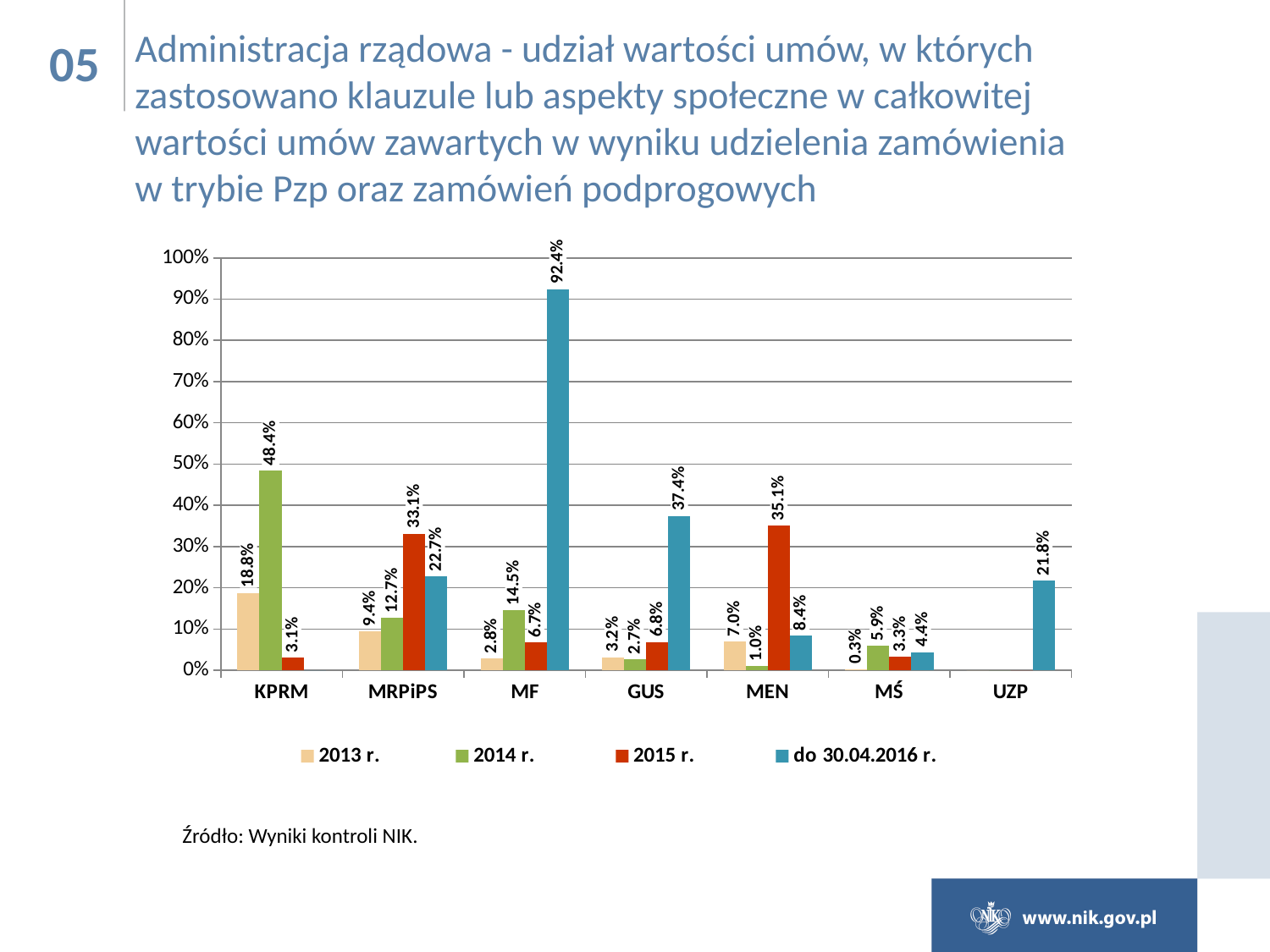
What is the value for MEN in the 2015 r. series? 35.1% Is the 'do 30.04.2016 r.' value for GUS greater or less than 30%? greater What is the difference between the 2015 r. value for MRPiPS and the 2015 r. value for KPRM? 30.0% What is the value for KPRM in the 2014 r. series? 48.4% Which category has the highest value in the 'do 30.04.2016 r.' series? MF How many series does the legend list? 4 What kind of chart is shown on the slide? Bar chart What is the value for MF in the 'do 30.04.2016 r.' series? 92.4% How many categories are shown on the x axis? 7 What is the value for UZP in the 'do 30.04.2016 r.' series? 21.8% Which is larger: the 2014 r. value for MF or the 2014 r. value for MRPiPS? MF